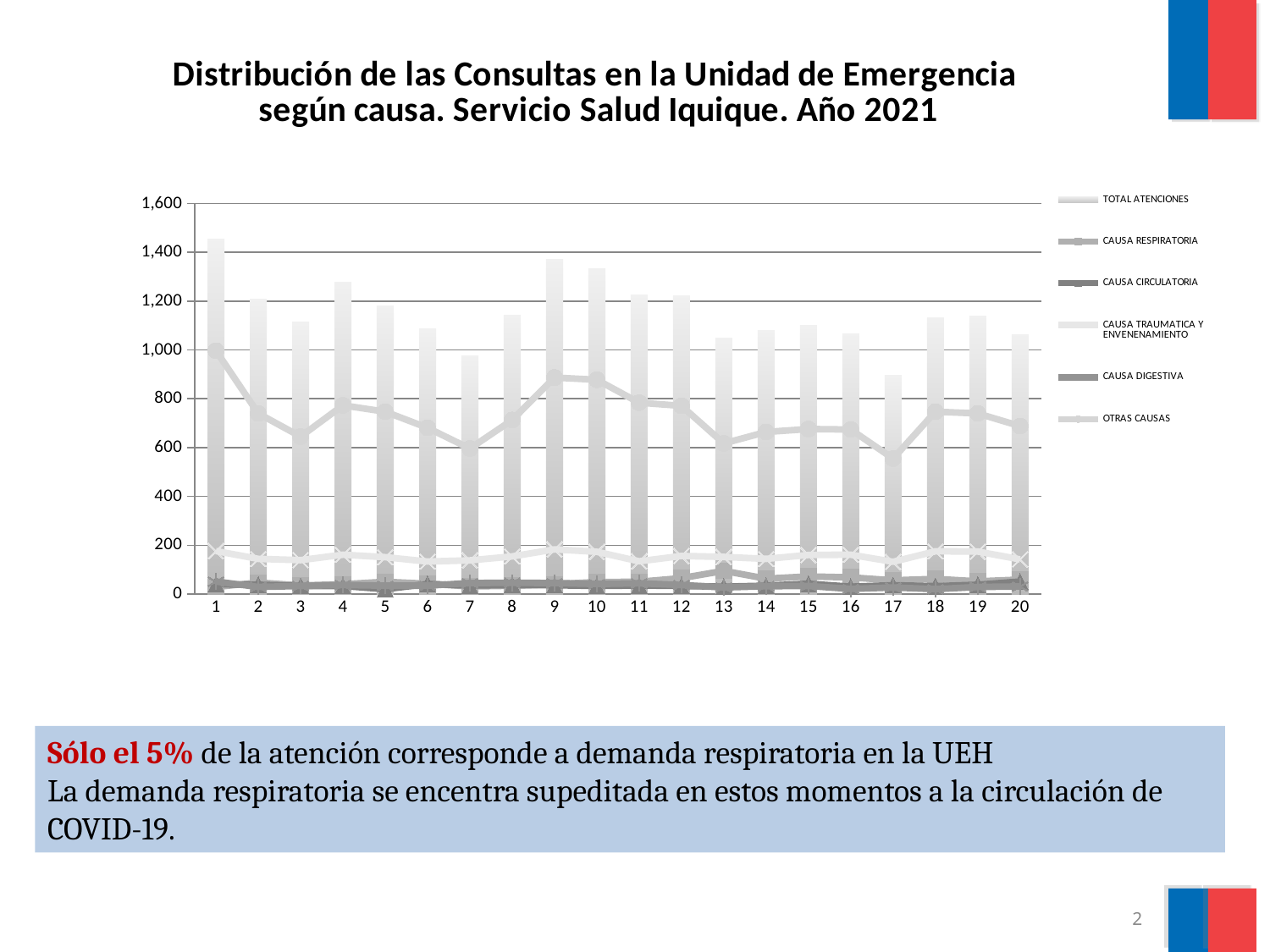
How many series does the chart's legend list? 6 Which series in the legend is plotted as bars rather than a line? TOTAL ATENCIONES Is the TOTAL ATENCIONES value for week 1 greater or less than 1,400? greater Which week has the highest TOTAL ATENCIONES bar? 1 Which is larger, the TOTAL ATENCIONES bar for week 1 or for week 20? Week 1 Does the TOTAL ATENCIONES series rise or fall from week 1 to week 3? Fall Is the TOTAL ATENCIONES value for week 9 greater or less than 1,200? greater How many categories (weeks) are shown on the x axis of the chart? 20 Is the TOTAL ATENCIONES value for week 17 greater or less than 1,000? less Which week has the lowest TOTAL ATENCIONES bar? 17 What kind of chart is shown on the slide? Combination bar and line chart